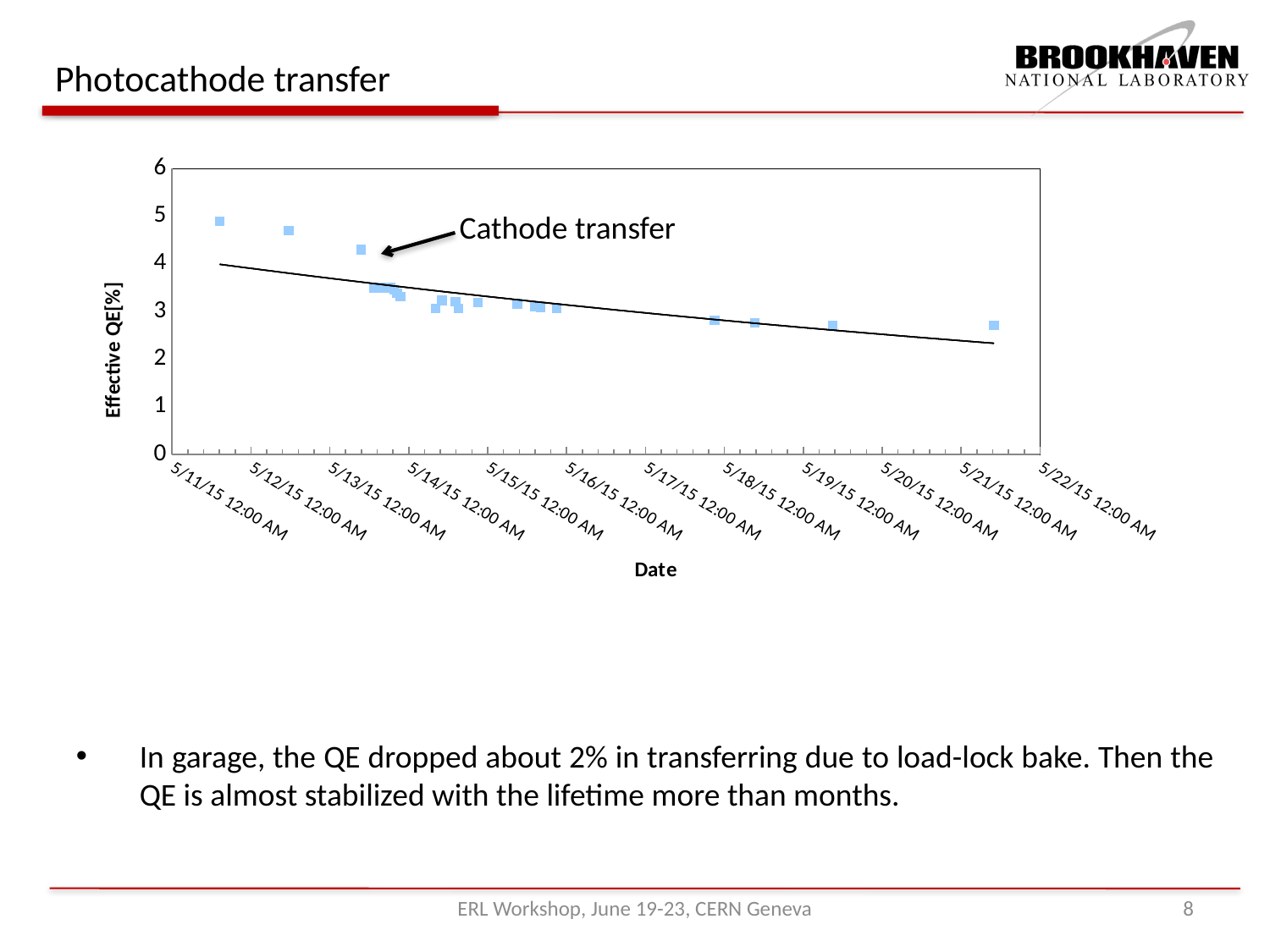
Which plotted point has the highest Effective QE value: the one near 5/11/15 or the one near 5/21/15? the one near 5/11/15 Is the value of the first plotted point (near 5/11/15) greater or less than 4? greater Do the plotted Effective QE values generally rise or fall as the date increases? fall What is the maximum value shown on the y axis? 6 What kind of chart is shown on the slide? scatter chart Is the value of the plotted point near 5/18/15 greater or less than 3? less Is the value of the plotted point near 5/13/15 12:00 AM greater or less than 4? greater How many date labels are shown along the x axis? 12 What is the label of the y axis? Effective QE[%]